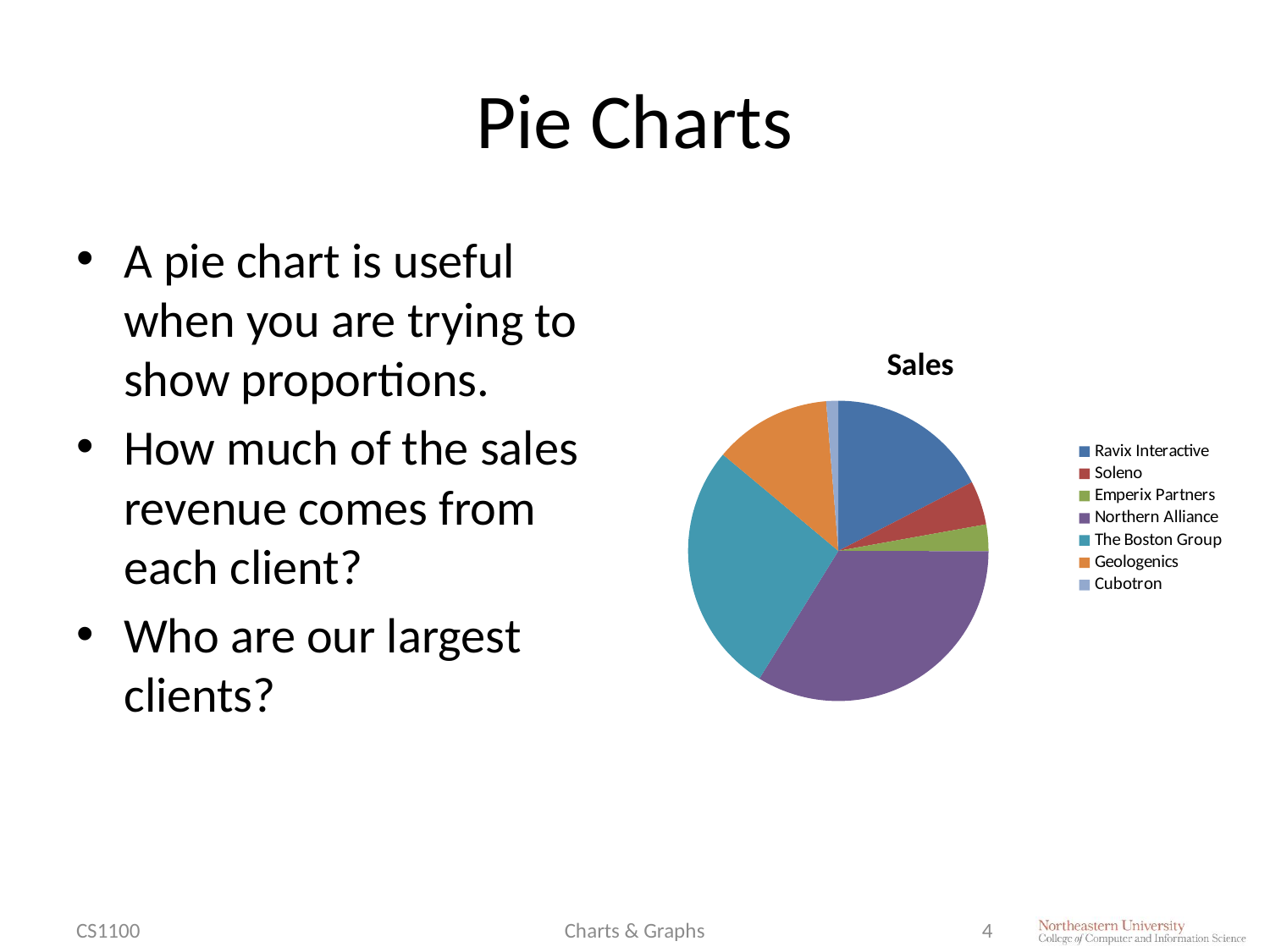
What kind of chart is shown on the slide? pie chart Which client is the second-largest slice of the pie? The Boston Group Which client has the largest slice of the pie? Northern Alliance Which slice is larger, Northern Alliance or The Boston Group? Northern Alliance Which client has the smallest slice of the pie? Cubotron What is the title of the chart? Sales How many slices does the pie chart have? 7 Which slice is larger, The Boston Group or Ravix Interactive? The Boston Group What colour is the Northern Alliance slice? purple Which slice is larger, Soleno or Cubotron? Soleno How many entries does the legend list? 7